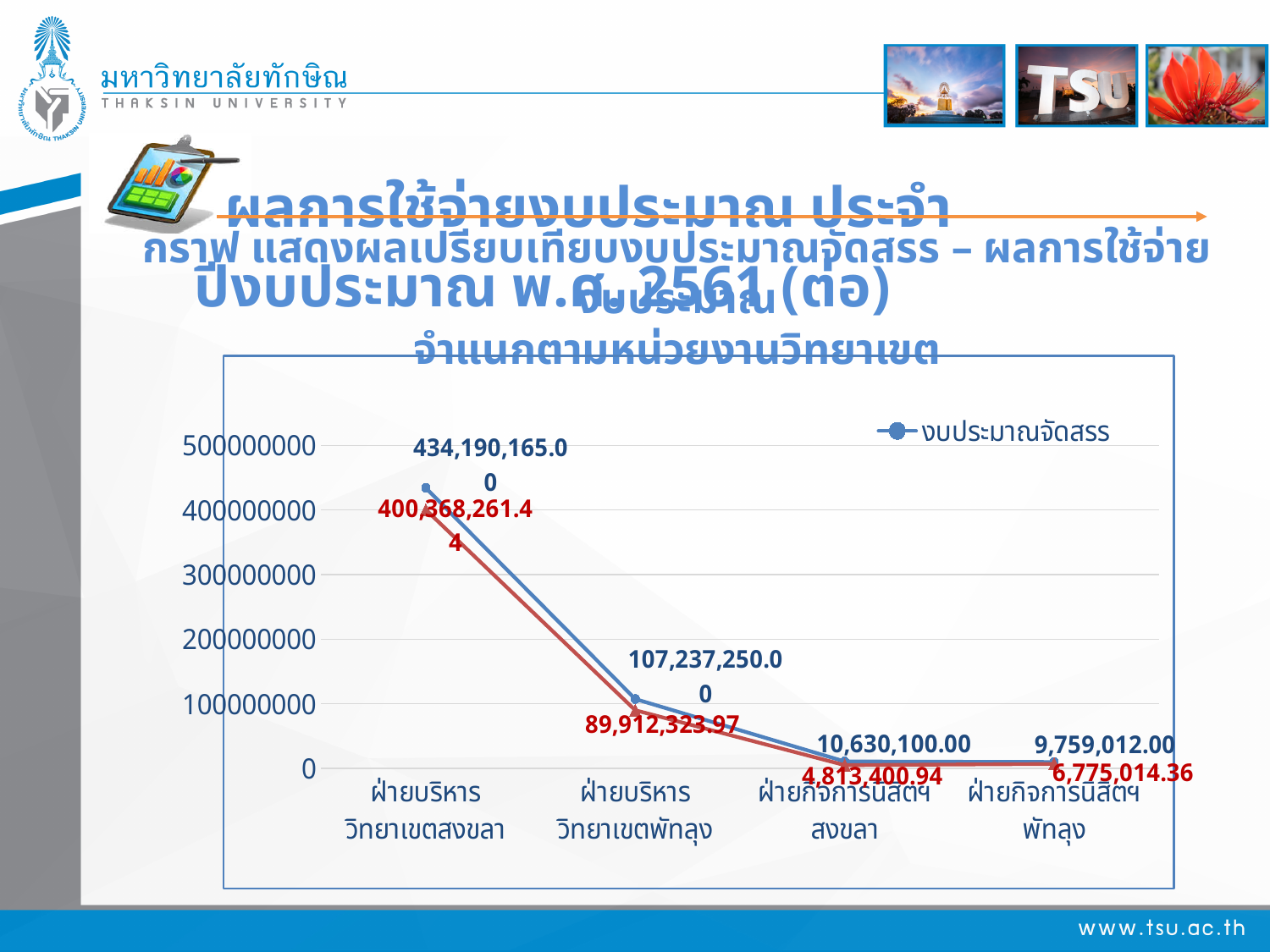
For ฝ่ายบริหารวิทยาเขตสงขลา, which is larger: the งบประมาณจัดสรร value or the red line value? งบประมาณจัดสรร What is the value of the red line for ฝ่ายกิจการนิสิตฯ สงขลา? 4,813,400.94 What kind of chart is shown on the slide? line chart What is the value of the red line for ฝ่ายกิจการนิสิตฯ พัทลุง? 6,775,014.36 Which category has the highest งบประมาณจัดสรร value? ฝ่ายบริหารวิทยาเขตสงขลา Which category has the lowest งบประมาณจัดสรร value? ฝ่ายกิจการนิสิตฯ พัทลุง What is the งบประมาณจัดสรร value for ฝ่ายบริหารวิทยาเขตพัทลุง? 107,237,250.00 What is the งบประมาณจัดสรร value for ฝ่ายบริหารวิทยาเขตสงขลา? 434,190,165.00 Is the red line value for ฝ่ายบริหารวิทยาเขตสงขลา greater or less than 300000000? greater What is the difference between the งบประมาณจัดสรร value and the red line value for ฝ่ายบริหารวิทยาเขตพัทลุง? 17,324,926.03 How many categories are shown on the x axis of the chart? 4 Does the งบประมาณจัดสรร line rise or fall from left to right across the categories? fall